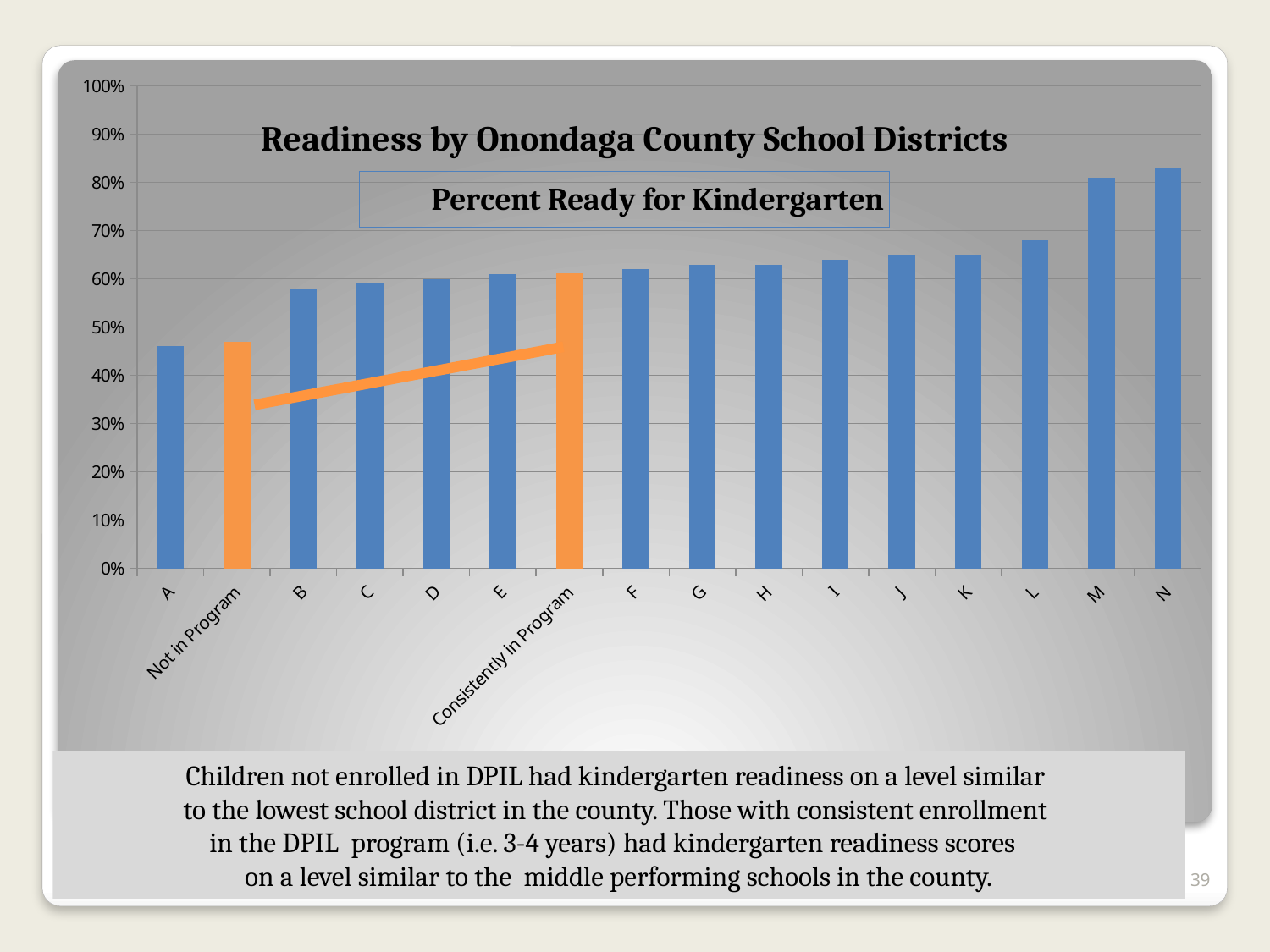
What colour are the bars for Not in Program and Consistently in Program? Orange What kind of chart is shown on the slide? Bar chart Which category has the highest percent ready for kindergarten? N Which is larger, the value for M or the value for L? M Is the value for Not in Program greater or less than 50%? less How many categories are shown along the x axis of the chart? 16 Which is larger, the value for Consistently in Program or the value for Not in Program? Consistently in Program Do the values generally rise or fall moving from left to right along the x axis? Rise Is the value for L greater or less than 70%? less Is the value for N greater or less than 80%? greater